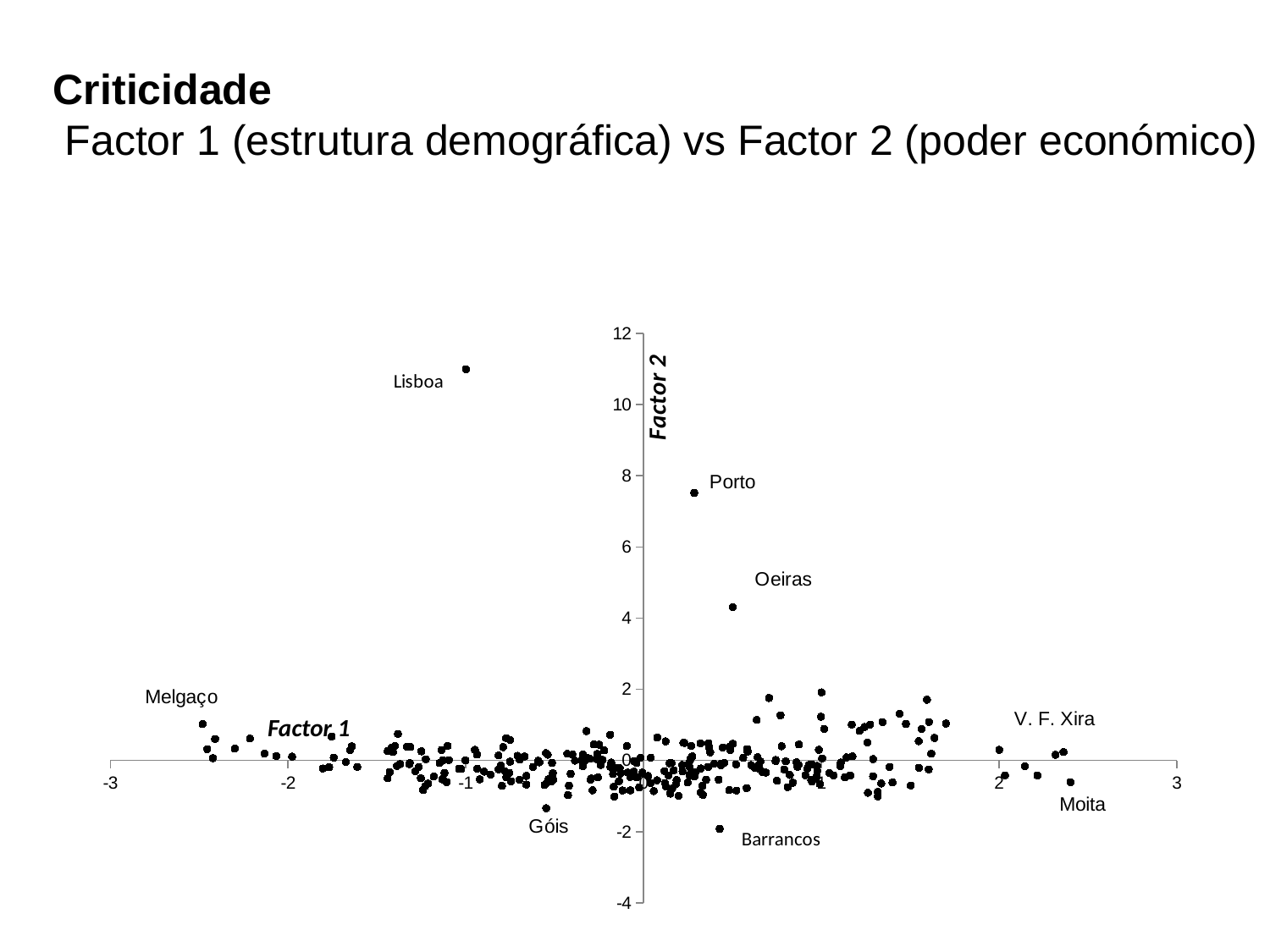
Which labelled point lies furthest to the left on the Factor 1 axis? Melgaço Is the Factor 2 value for Lisboa greater or less than 10? greater Which labelled point has the highest Factor 2 value? Lisboa Is the Factor 2 value for Oeiras greater or less than 6? less Which has the larger Factor 2 value, Porto or Oeiras? Porto What kind of chart is shown on the slide? scatter plot Is the Factor 1 value for Moita greater or less than 2? greater Which labelled point has the lowest Factor 2 value? Barrancos What is the label of the horizontal axis? Factor 1 What is the label of the vertical axis? Factor 2